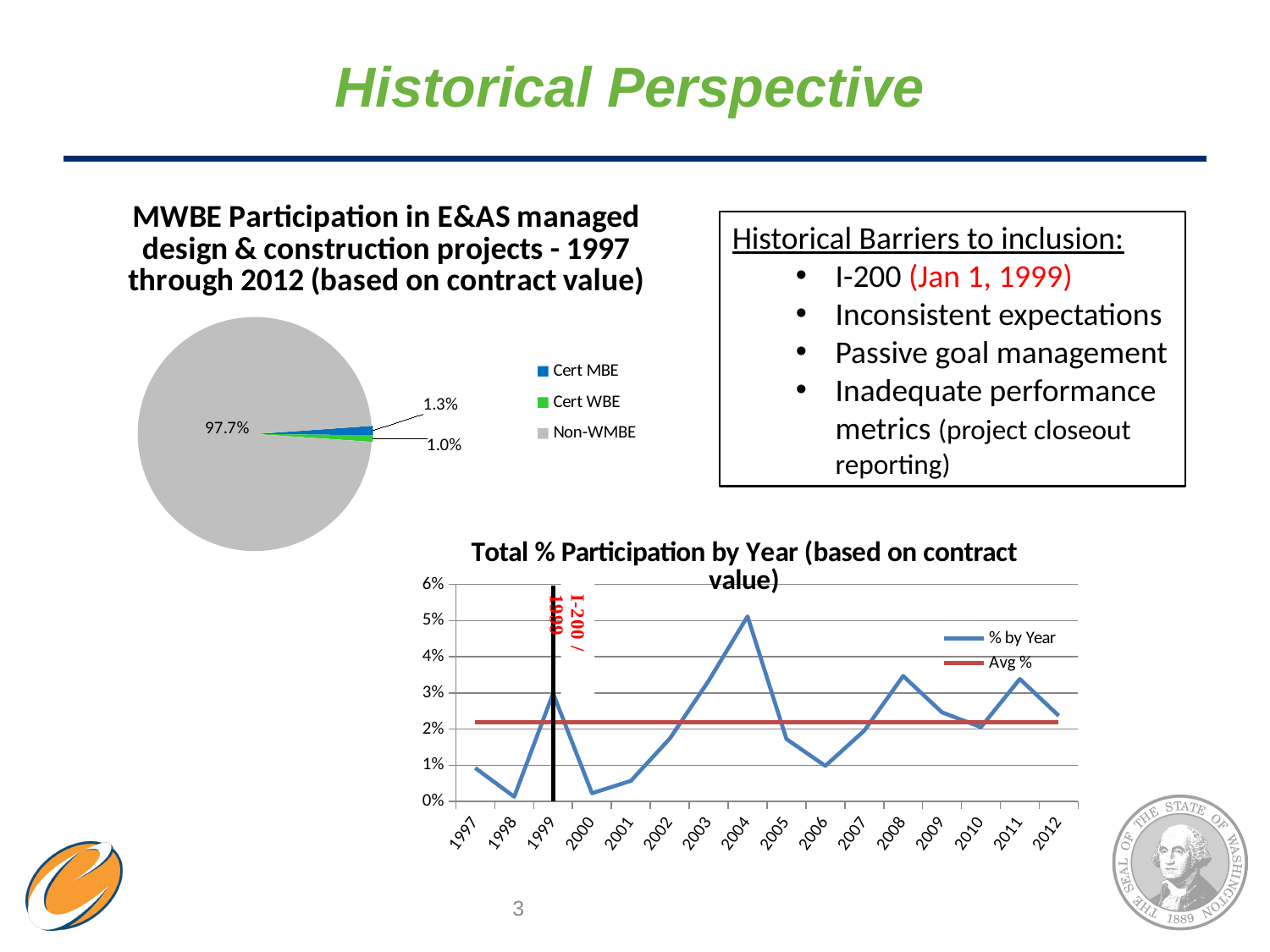
On the 'Total % Participation by Year' chart, which year has the highest % by Year value? 2004 On the pie chart, what percentage is shown for Cert WBE? 1.0% On the pie chart, how many categories does the legend list? 3 On the 'Total % Participation by Year' chart, is the % by Year value for 1998 greater or less than 1%? less On the 'Total % Participation by Year' chart, does the % by Year line rise or fall from 2004 to 2005? Fall What type of chart is the 'MWBE Participation in E&AS managed design & construction projects' chart? Pie chart On the 'Total % Participation by Year' chart, how many years are shown on the x axis? 16 On the 'Total % Participation by Year' chart, is the % by Year value for 2004 greater or less than 4%? greater On the pie chart, what percentage is shown for Cert MBE? 1.3% On the pie chart, what share is labelled for Non-WMBE? 97.7% On the 'Total % Participation by Year' chart, how many series does the legend list? 2 On the pie chart, which category has the largest slice? Non-WMBE